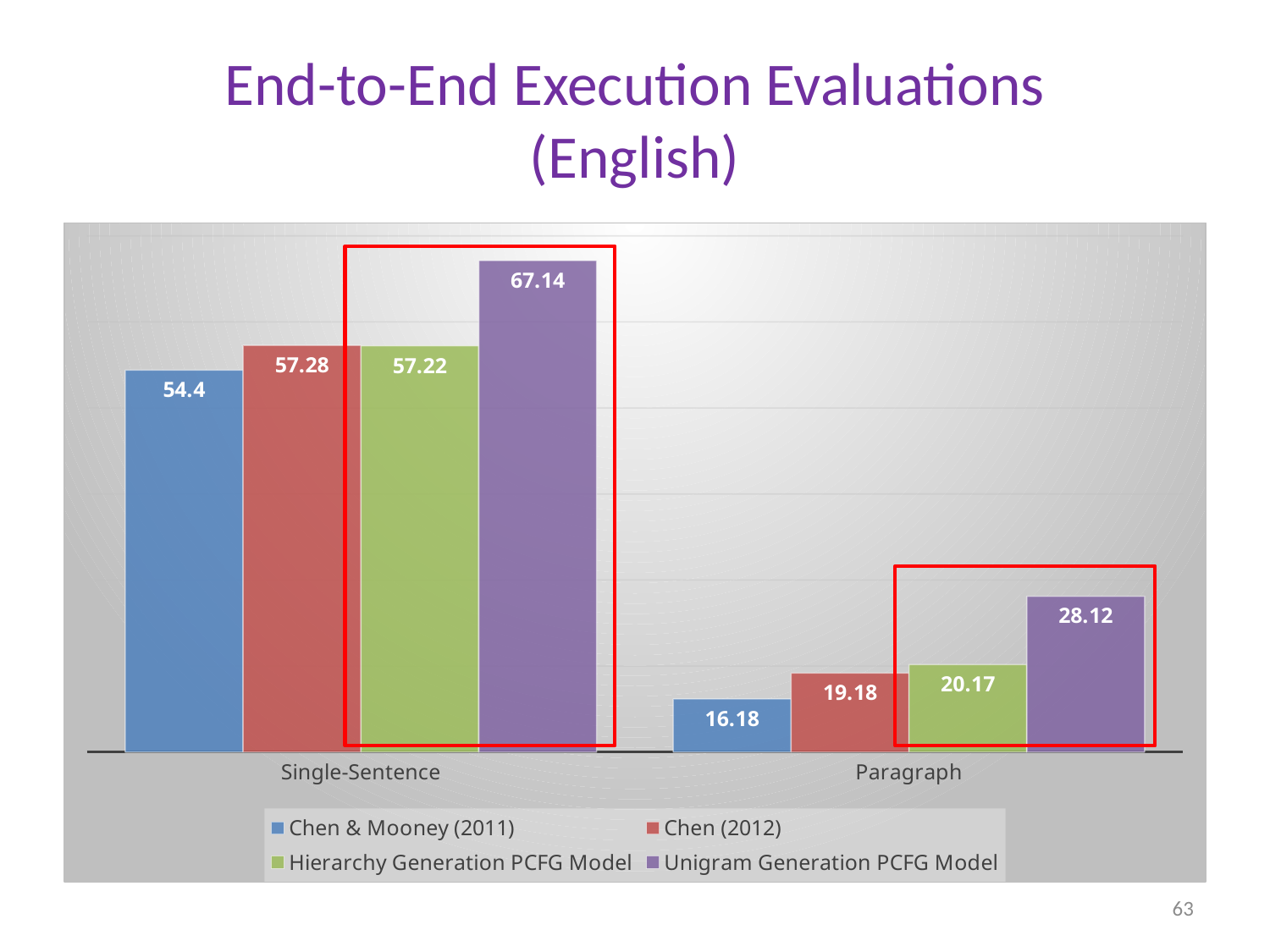
What is the value for Chen & Mooney (2011) in the Paragraph category? 16.18 Which series has the lowest value in the Single-Sentence category? Chen & Mooney (2011) Which is larger: the Chen (2012) value for Paragraph or the Hierarchy Generation PCFG Model value for Paragraph? Hierarchy Generation PCFG Model What kind of chart is shown on the slide? Bar chart How many series does the legend list? 4 Which series has the highest value in the Paragraph category? Unigram Generation PCFG Model What is the value for Unigram Generation PCFG Model in the Single-Sentence category? 67.14 How many categories are shown on the x axis? 2 What is the difference between the Unigram Generation PCFG Model and Hierarchy Generation PCFG Model values in the Paragraph category? 7.95 What is the value for Hierarchy Generation PCFG Model in the Paragraph category? 20.17 What is the value for Chen (2012) in the Single-Sentence category? 57.28 What is the difference between the Unigram Generation PCFG Model and Chen & Mooney (2011) values in the Single-Sentence category? 12.74